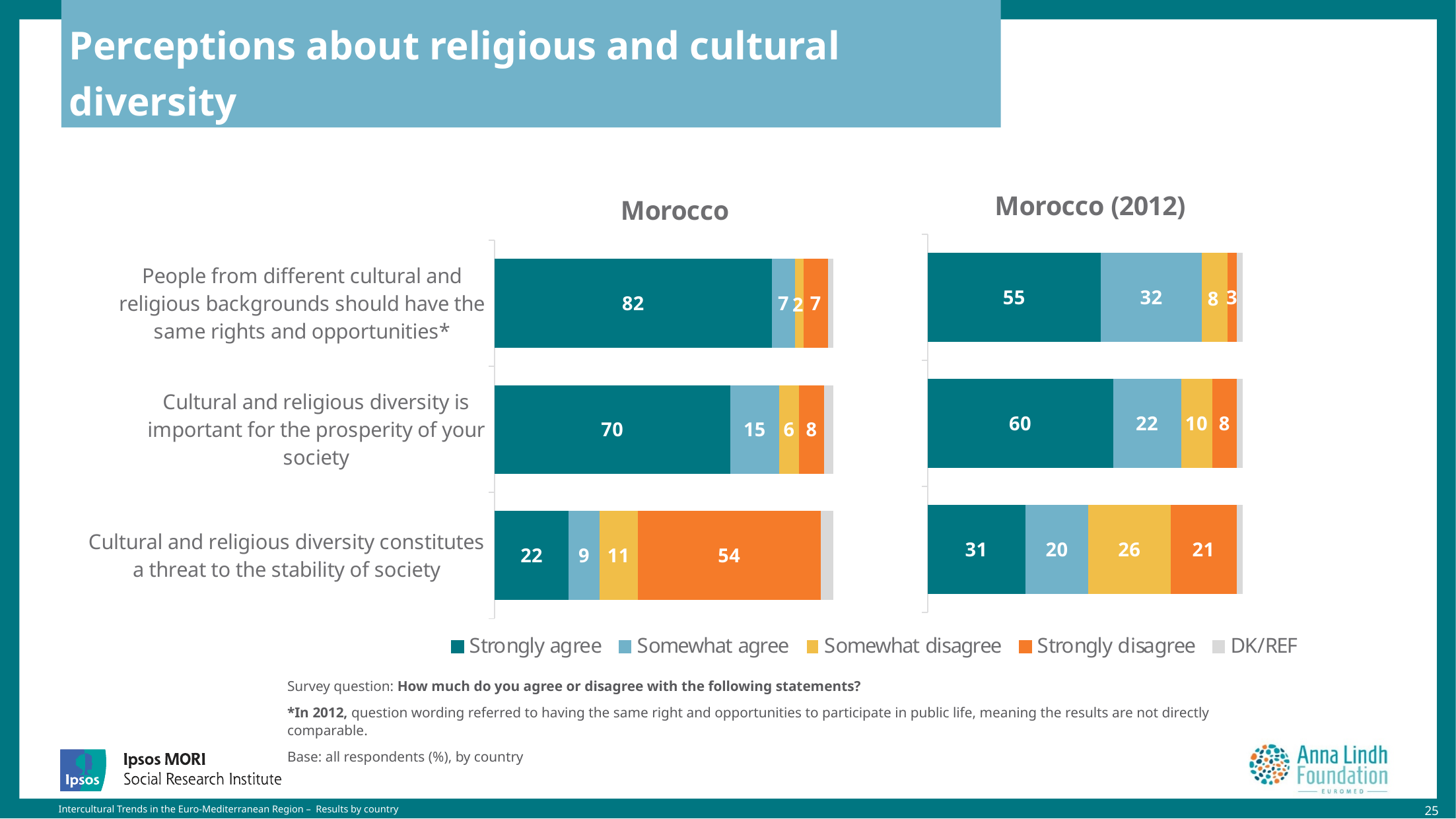
In the Morocco chart, what percentage strongly agree that people from different cultural and religious backgrounds should have the same rights and opportunities? 82 In the Morocco chart, which statement has the highest 'Strongly agree' value? People from different cultural and religious backgrounds should have the same rights and opportunities* How many series does the legend list for the charts? 5 In the Morocco chart, what percentage strongly disagree that cultural and religious diversity constitutes a threat to the stability of society? 54 Which legend entry is shown in light grey? DK/REF What is the difference between the 'Strongly agree' value for the same rights statement in the Morocco chart and in the Morocco (2012) chart? 27 In the Morocco (2012) chart, what percentage somewhat disagree that cultural and religious diversity constitutes a threat to the stability of society? 26 How many statements are shown in the Morocco chart? 3 What type of chart is the Morocco (2012) chart? Stacked bar chart For the statement that diversity constitutes a threat, is the 'Strongly disagree' value larger in the Morocco chart or the Morocco (2012) chart? Morocco In the Morocco (2012) chart, which statement has the lowest 'Strongly agree' value? Cultural and religious diversity constitutes a threat to the stability of society In the Morocco (2012) chart, what percentage somewhat agree that cultural and religious diversity is important for the prosperity of your society? 22